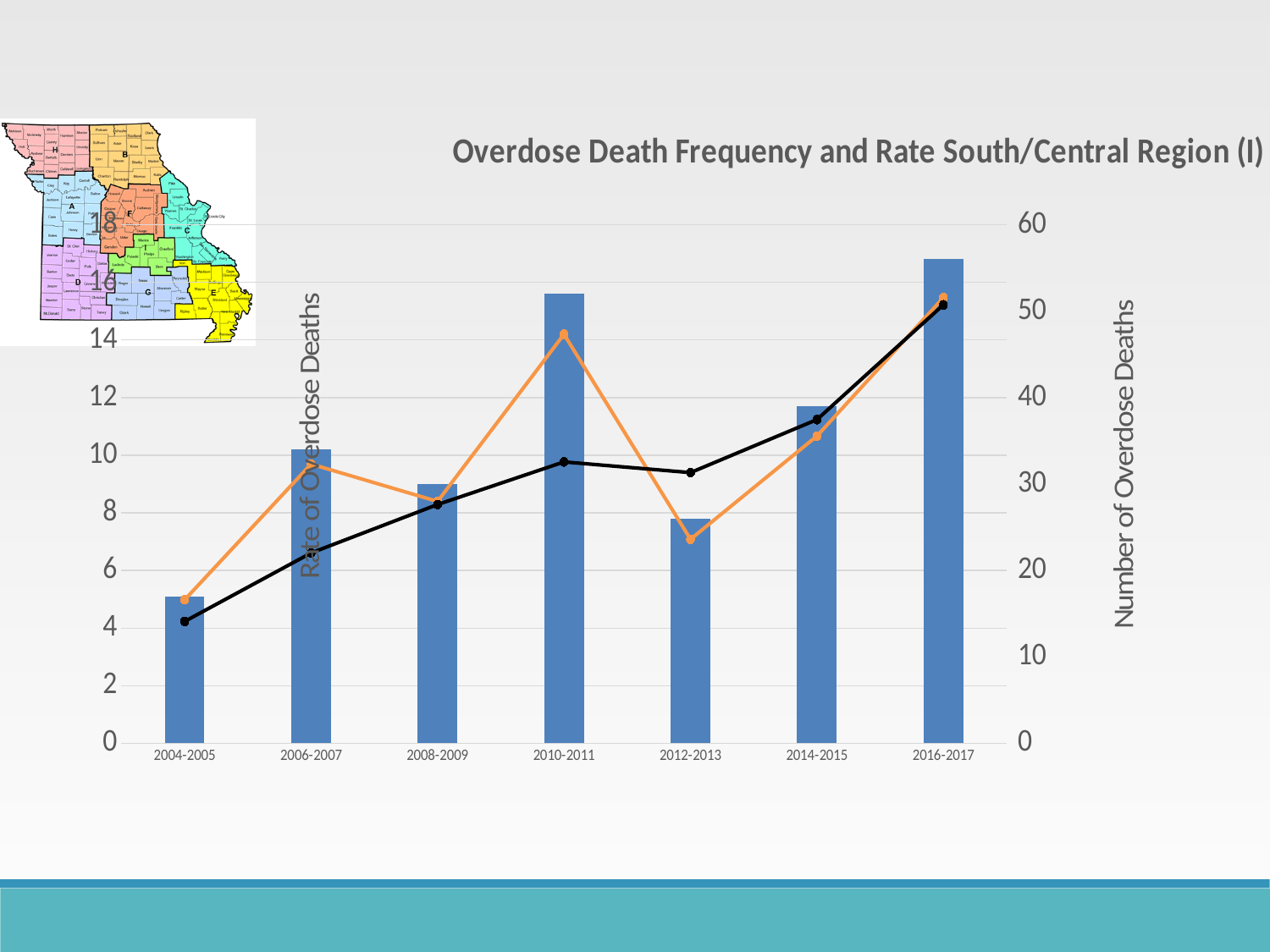
Is the Number of Overdose Deaths bar for 2004-2005 greater or less than 20? less What is the title of the chart? Overdose Death Frequency and Rate South/Central Region (I) What kind of chart is shown on the slide? A bar chart combined with line charts Is the Number of Overdose Deaths bar for 2012-2013 greater or less than 30? less In which time period does the orange line reach its highest point? 2016-2017 What is the title of the right-hand vertical axis? Number of Overdose Deaths Which time period has the shortest bar for Number of Overdose Deaths? 2004-2005 Which bar is taller, 2010-2011 or 2014-2015? 2010-2011 Does the black line rise or fall overall from 2004-2005 to 2016-2017? Rise How many time periods are shown on the x axis of the chart? 7 Is the Number of Overdose Deaths bar for 2016-2017 greater or less than 50? greater Which time period has the tallest bar for Number of Overdose Deaths? 2016-2017